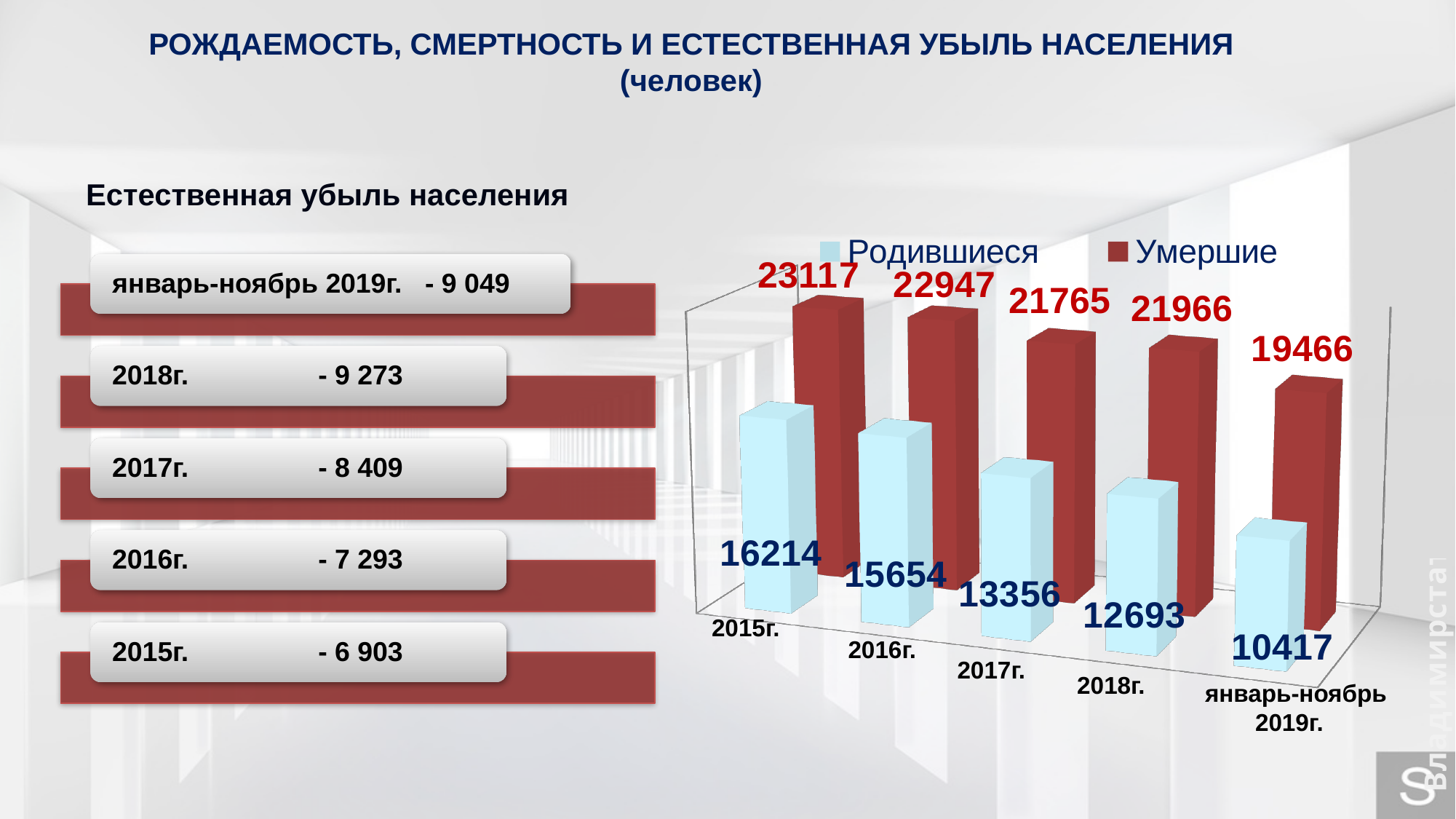
How many categories (periods) are shown on the x axis of the bar chart? 5 How many series does the legend of the bar chart list? 2 What type of chart is shown on the right side of the slide? bar chart Which is larger in 2016г., Родившиеся or Умершие? Умершие In which period is the Родившиеся value lowest? январь-ноябрь 2019г. What is the difference between Умершие and Родившиеся in 2018г.? 9273 Do the Родившиеся values rise or fall from 2015г. to январь-ноябрь 2019г.? fall What is the value for Родившиеся in январь-ноябрь 2019г.? 10417 What is the value for Родившиеся in 2015г.? 16214 In which period is the Умершие value highest? 2015г. What colour are the bars for the Умершие series? red What is the value for Умершие in 2017г.? 21765